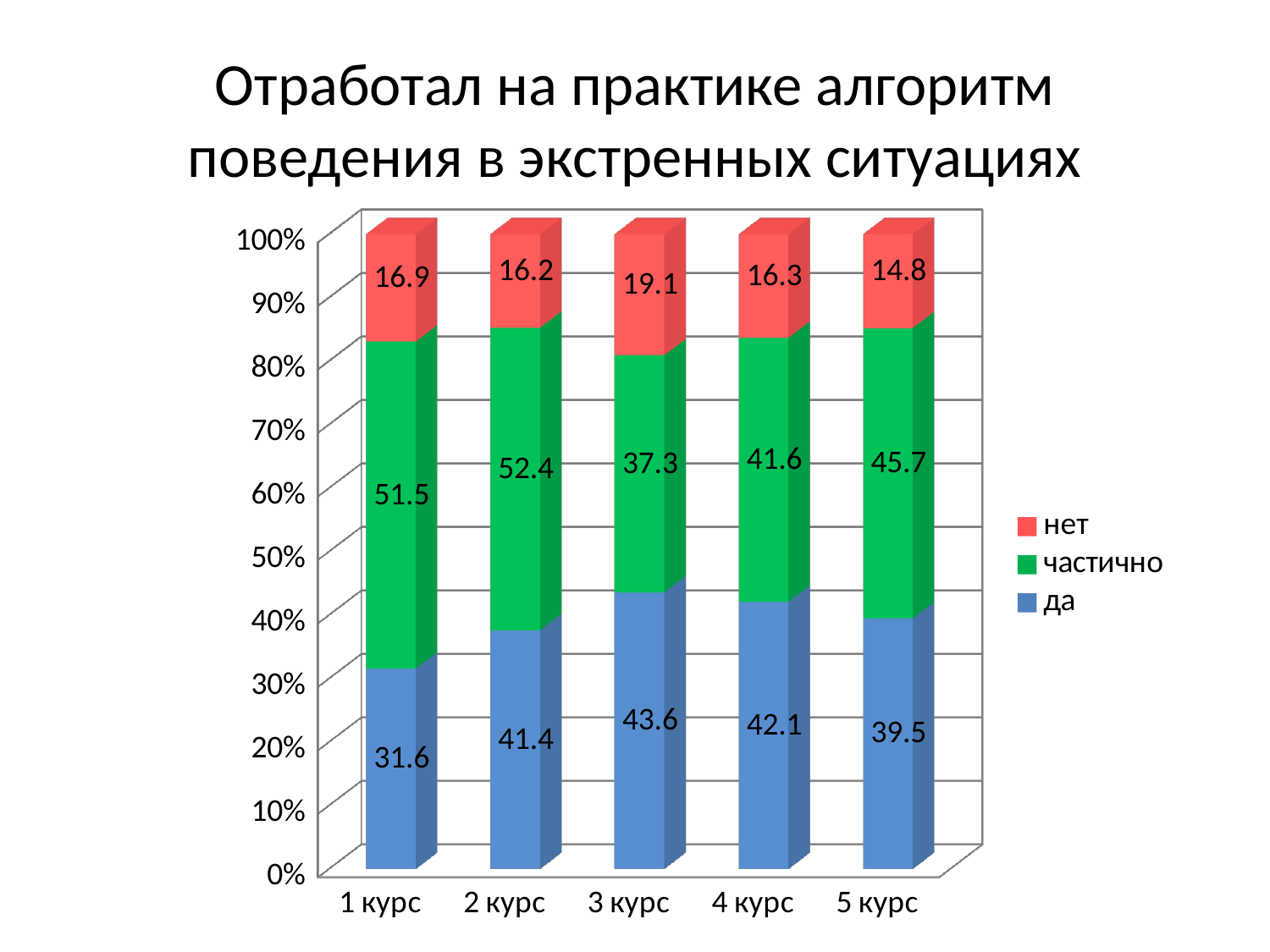
Which is larger: the "частично" value for 4 курс or for 5 курс? 5 курс What kind of chart is shown on the slide? Stacked bar chart What is the difference between the "да" values for 3 курс and 1 курс? 12 Which course has the highest value for "нет"? 3 курс Which colour represents the "да" series? Blue What is the value for "да" for 3 курс? 43.6 What is the value for "частично" for 2 курс? 52.4 What is the value for "нет" for 5 курс? 14.8 Which course has the highest value for "частично"? 2 курс Which course has the lowest value for "да"? 1 курс How many series does the legend list? 3 How many courses (categories) are shown on the x axis? 5